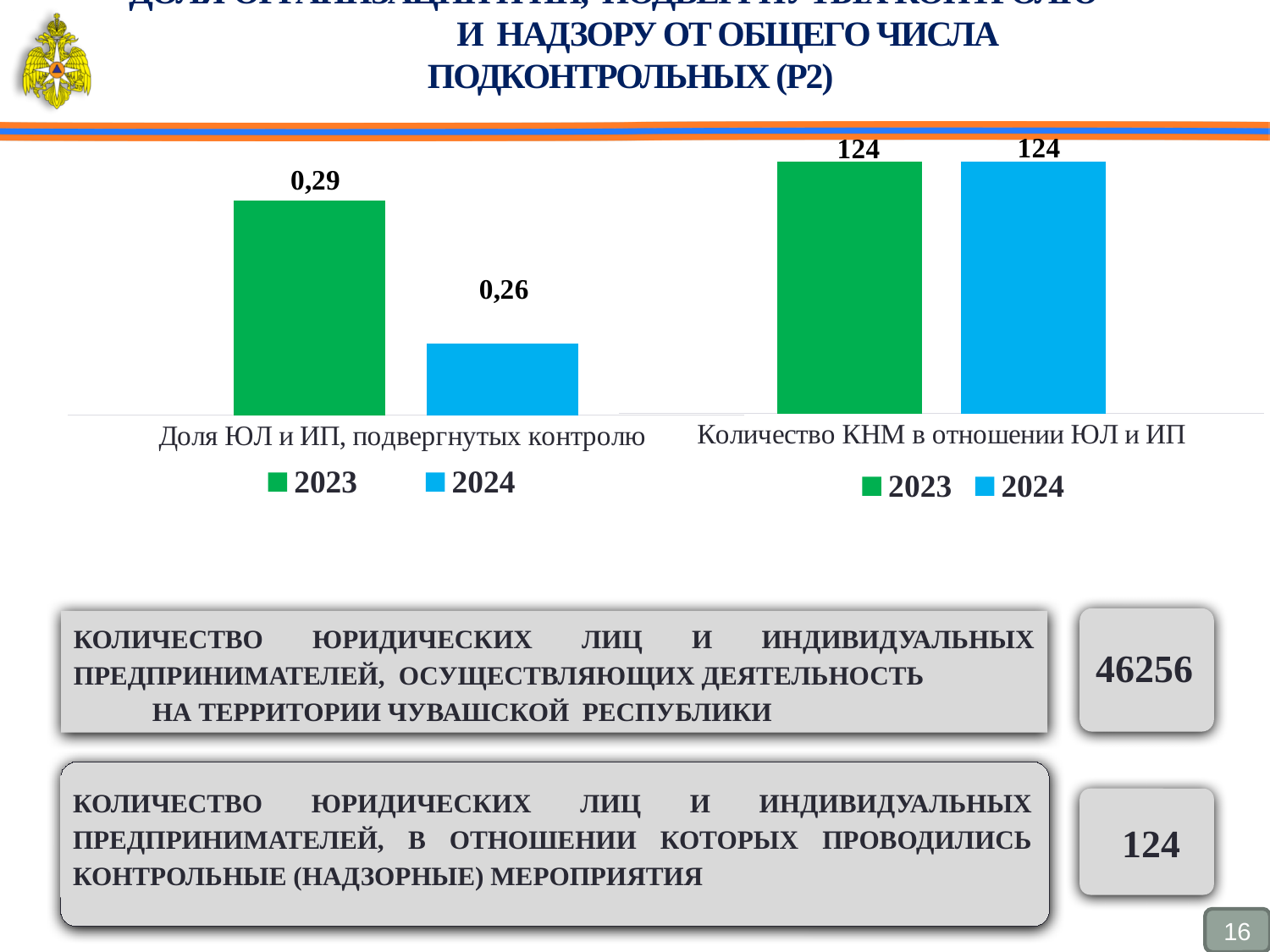
In the left chart, what is the difference between the 2023 and 2024 values? 0,03 What are the legend entries of the right chart? 2023, 2024 In the right chart (Количество КНМ в отношении ЮЛ и ИП), what is the value for 2023? 124 How many series does the legend of the left chart list? 2 In the right chart, what is the difference between the 2023 and 2024 values? 0 In the left chart (Доля ЮЛ и ИП, подвергнутых контролю), what is the value for 2023? 0,29 In the left chart, does the value rise or fall from 2023 to 2024? fall In the right chart, which colour represents 2024? blue In the left chart, which year has the higher value, 2023 or 2024? 2023 In the left chart (Доля ЮЛ и ИП, подвергнутых контролю), what is the value for 2024? 0,26 In the right chart (Количество КНМ в отношении ЮЛ и ИП), what is the value for 2024? 124 What type of chart is the right chart (Количество КНМ в отношении ЮЛ и ИП)? bar chart